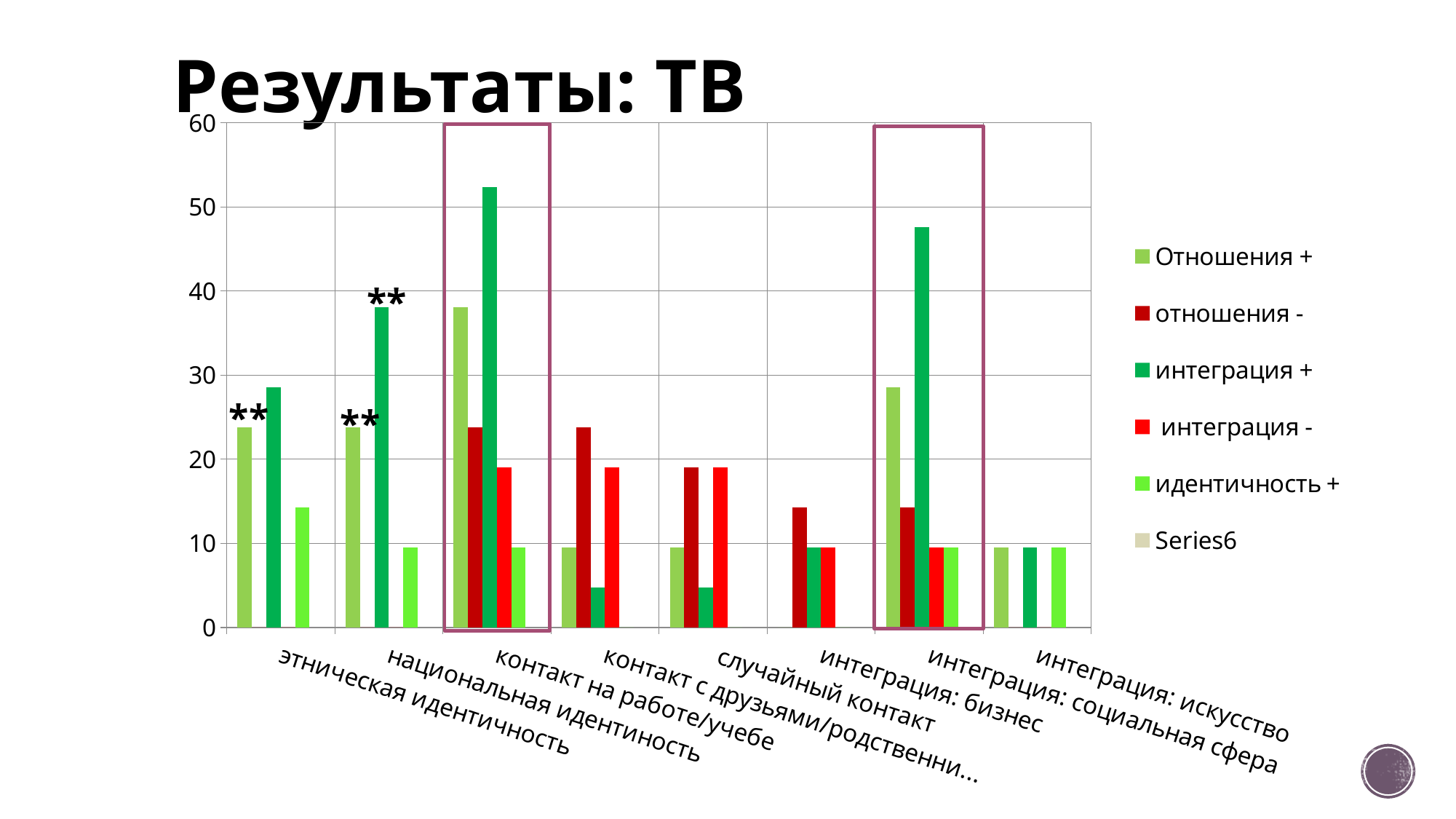
What kind of chart is shown on the slide? bar chart Is the value of 'Отношения +' for 'контакт на работе/учебе' greater or less than 40? less How many categories are shown along the x axis of the chart? 8 Is the value of 'интеграция +' for 'интеграция: социальная сфера' greater or less than 50? less Is the value of 'интеграция +' for 'случайный контакт' greater or less than 10? less Which is larger: the 'интеграция +' value for 'контакт на работе/учебе' or for 'интеграция: социальная сфера'? контакт на работе/учебе How many series does the chart legend list? 6 Which category has the highest value for the series 'интеграция +'? контакт на работе/учебе What is the title of the slide containing the chart? Результаты: ТВ What is the last entry in the chart legend? Series6